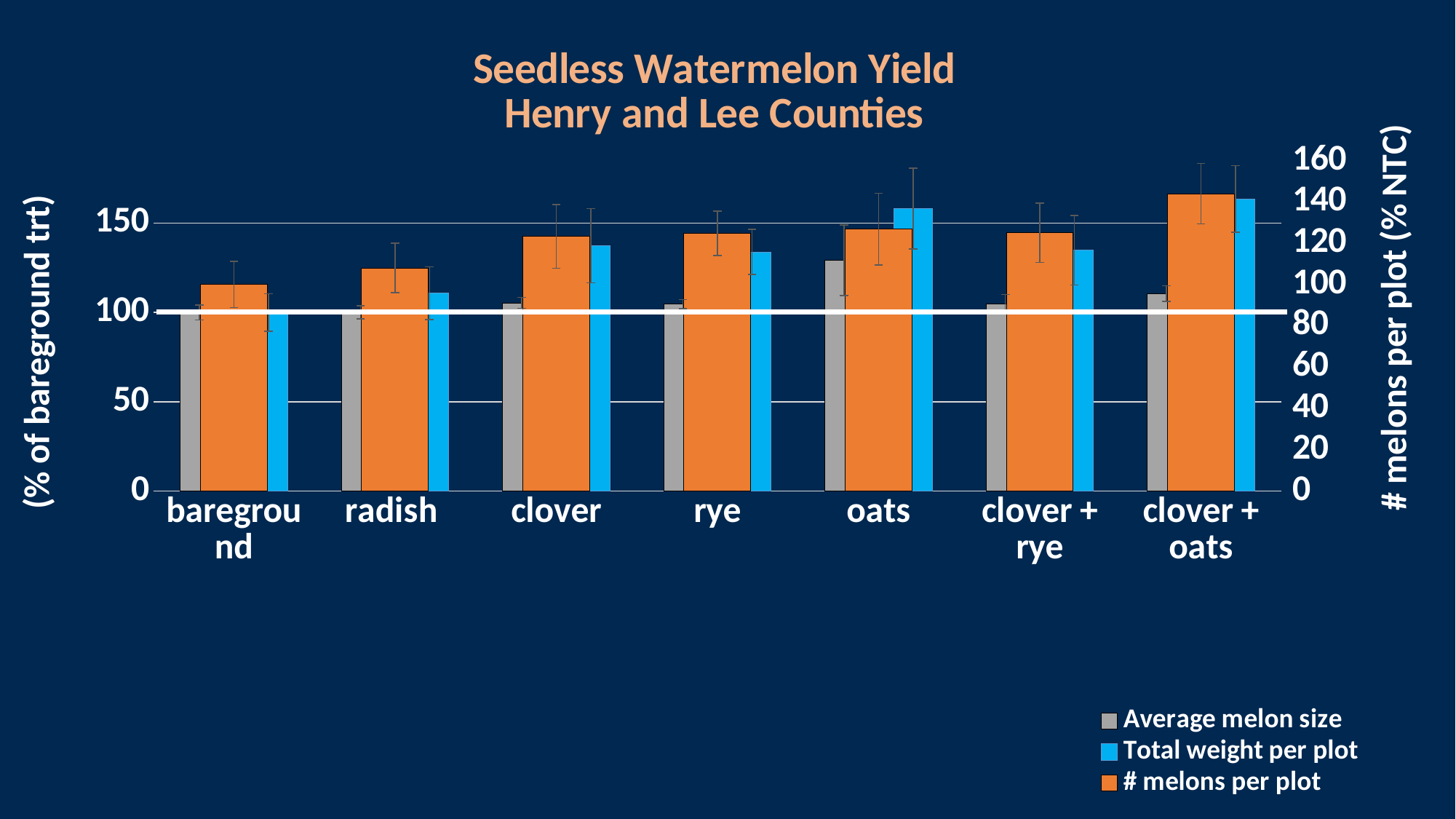
What kind of chart is shown on the slide? bar chart Is the Average melon size for oats greater or less than 100? greater Which treatment has the highest Total weight per plot? clover + oats Is the Total weight per plot for clover + oats greater or less than 150? greater Which is larger, the Total weight per plot for oats or for rye? oats Which treatment has the highest Average melon size? oats What colour are the bars for Total weight per plot? blue Which treatment has the lowest Total weight per plot? bareground How many treatment categories are shown on the x axis? 7 Which treatment has the highest # melons per plot? clover + oats How many series does the legend list? 3 Is the Total weight per plot for clover greater or less than 150? less